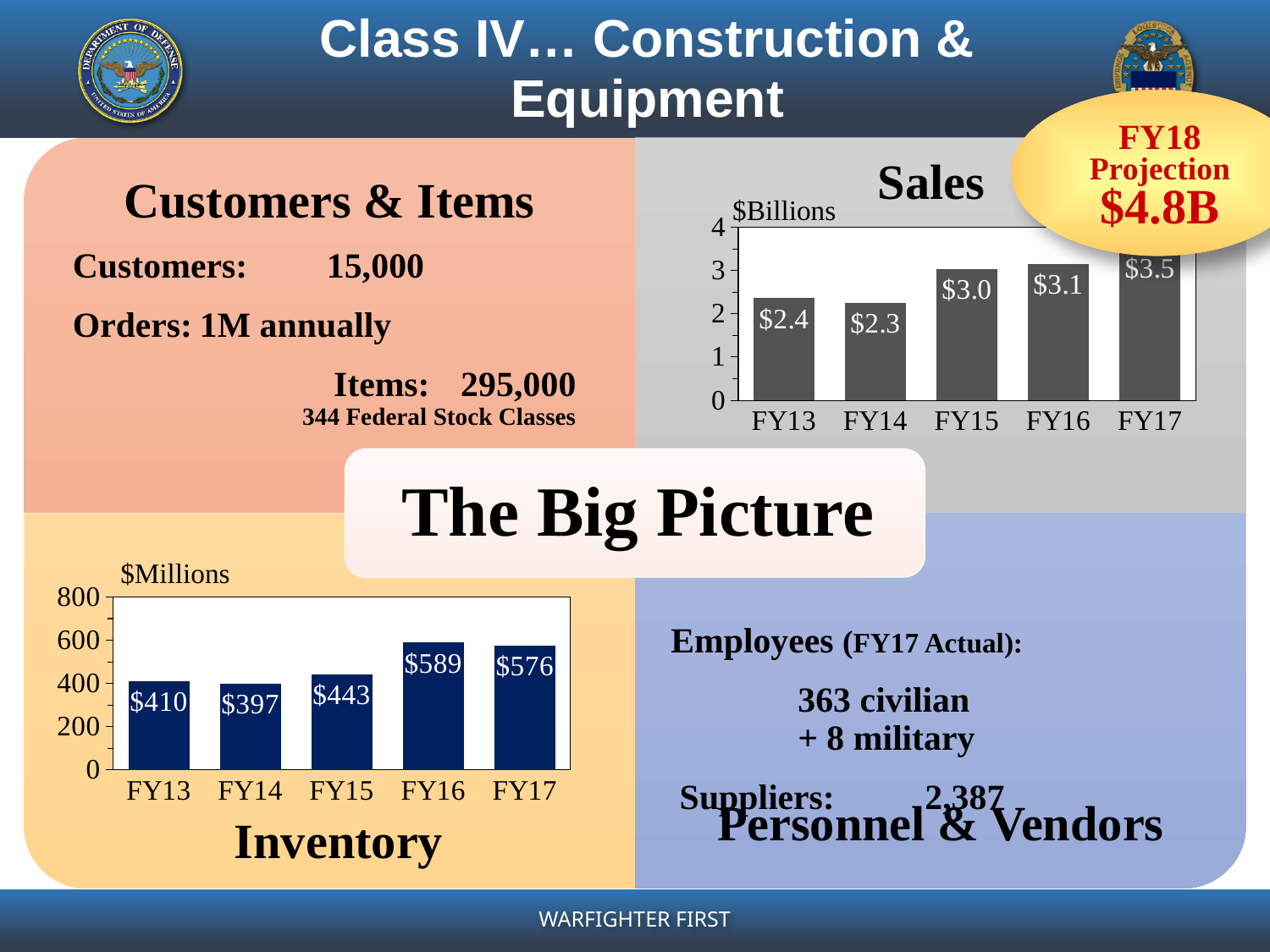
In the Inventory chart, which fiscal year has the lowest inventory? FY14 In the Sales chart, what unit is shown above the y axis? $Billions In the Sales chart, which fiscal year has the lowest sales? FY14 In the Sales chart, how many fiscal years are plotted? 5 In the Inventory chart, which fiscal year has the highest inventory? FY16 In the Inventory chart, what is the value for FY16? $589 In the Sales chart, what is the value for FY15? $3.0 In the Inventory chart, is the value for FY15 larger or smaller than the value for FY13? larger In the Sales chart, which fiscal year has the highest sales? FY17 What type of chart is the Inventory chart? bar chart In the Sales chart, what is the difference between the FY17 and FY13 values? $1.1 In the Inventory chart, what is the difference between the FY16 and FY17 values? $13